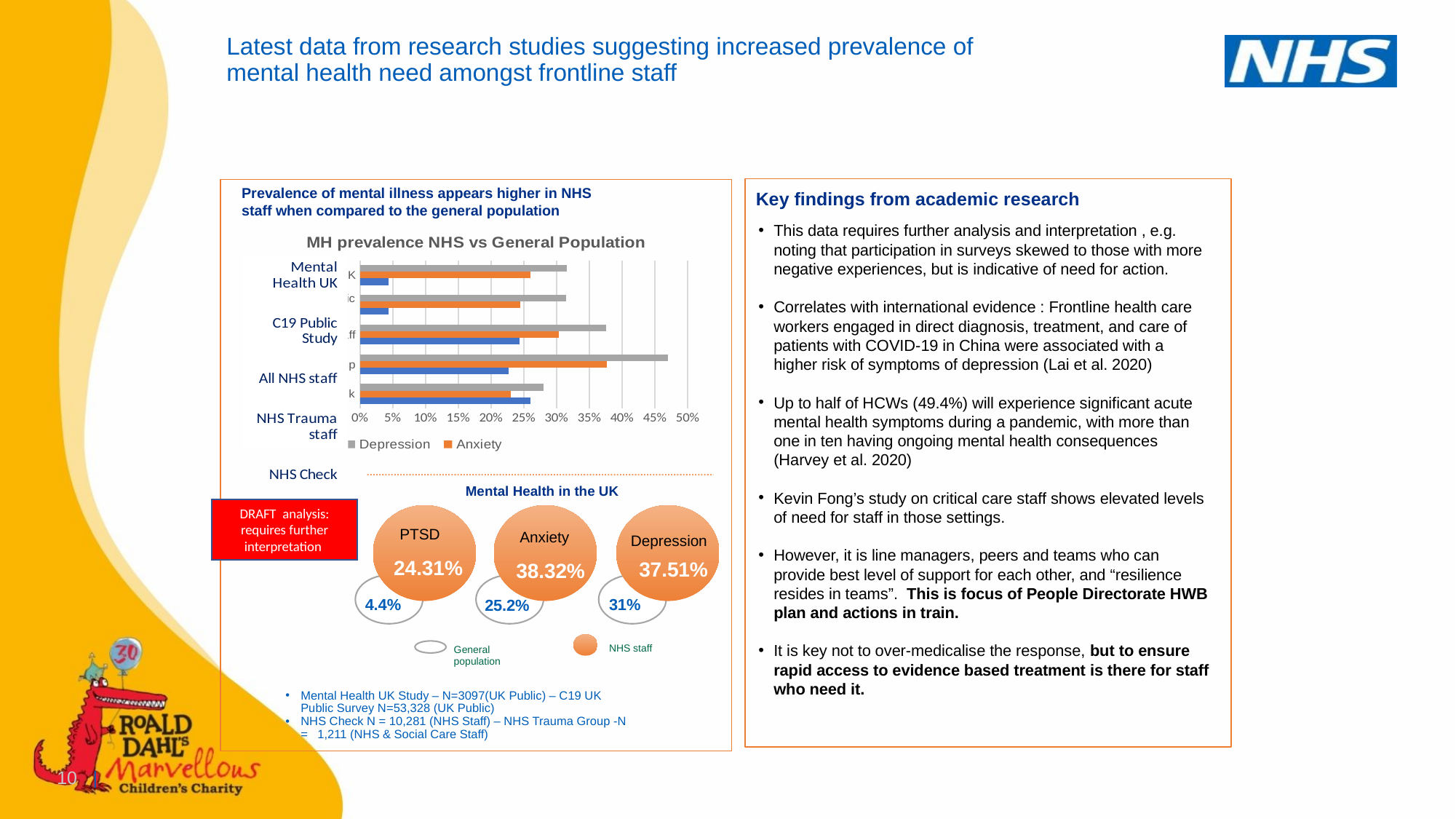
In the 'Mental Health in the UK' chart, which condition has the lowest general population value? PTSD How many groups of bars are plotted in the 'MH prevalence NHS vs General Population' chart? 5 In the 'Mental Health in the UK' chart, what is the NHS staff value for PTSD? 24.31% What kind of chart is 'MH prevalence NHS vs General Population'? Bar chart In the 'Mental Health in the UK' chart, what is the NHS staff value for Depression? 37.51% In the 'Mental Health in the UK' chart, what is the difference between the NHS staff and general population values for Depression? 6.51 percentage points In the 'Mental Health in the UK' chart, what is the general population value for PTSD? 4.4% In the 'Mental Health in the UK' chart, what is the general population value for Anxiety? 25.2% In the 'Mental Health in the UK' chart, what is the difference between the NHS staff and general population values for PTSD? 19.91 percentage points In the 'Mental Health in the UK' chart, which condition has the highest NHS staff value? Anxiety In the 'Mental Health in the UK' chart, which is larger: the NHS staff value for Anxiety or the NHS staff value for Depression? NHS staff value for Anxiety How many entries does the legend of the 'MH prevalence NHS vs General Population' chart list? 2